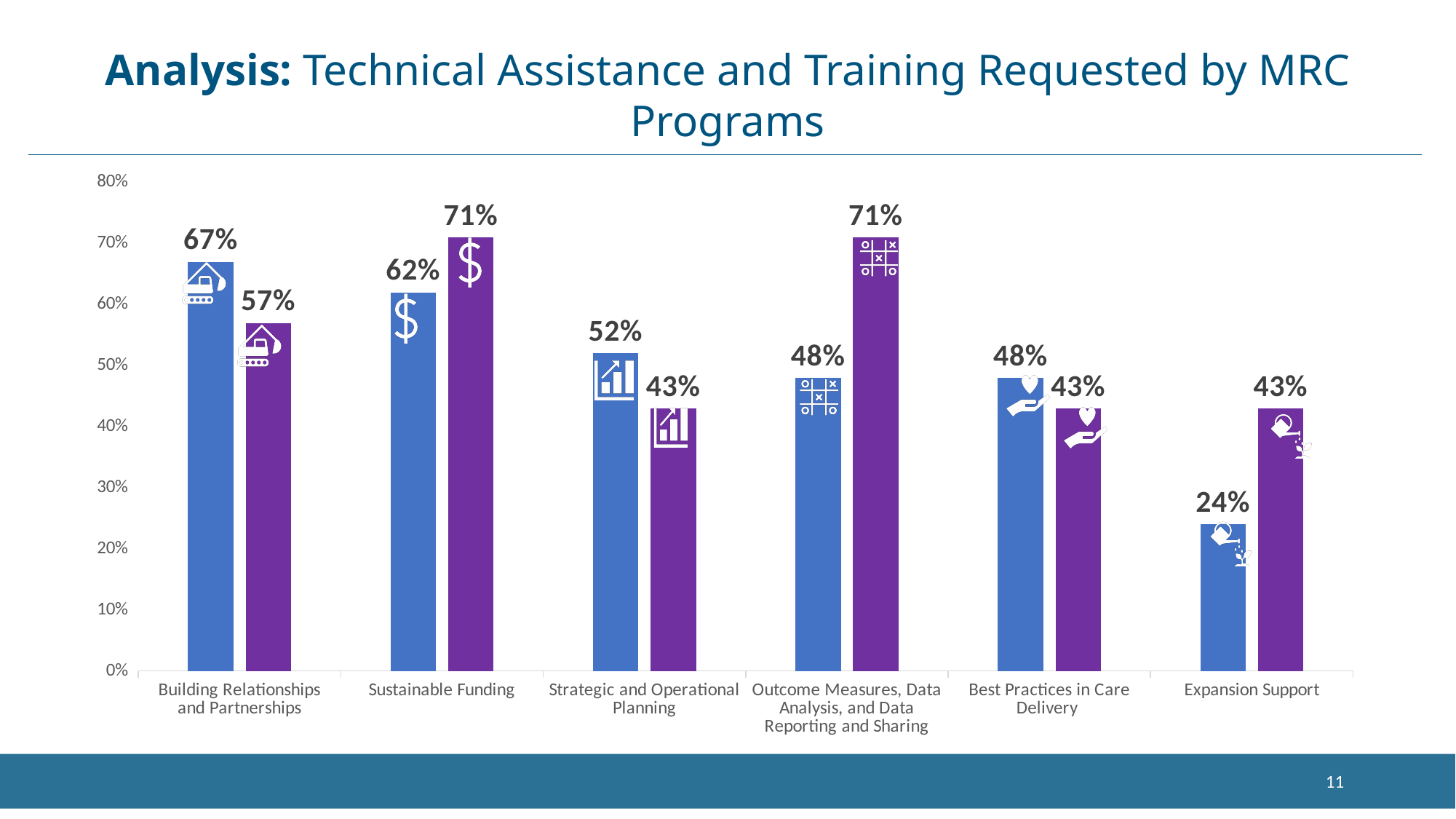
What is the difference between the blue and purple bars for Building Relationships and Partnerships? 10% What is the value of the blue bar for Sustainable Funding? 62% What is the value of the purple bar for Outcome Measures, Data Analysis, and Data Reporting and Sharing? 71% Which category has the lowest blue bar? Expansion Support For Strategic and Operational Planning, which bar is larger, the blue or the purple? blue What is the title of the slide? Analysis: Technical Assistance and Training Requested by MRC Programs What kind of chart is shown on the slide? bar chart What is the value of the blue bar for Expansion Support? 24% What is the difference between the purple and blue bars for Outcome Measures, Data Analysis, and Data Reporting and Sharing? 23% Which category has the highest blue bar? Building Relationships and Partnerships What is the value of the purple bar for Building Relationships and Partnerships? 57% How many categories are shown on the x axis? 6